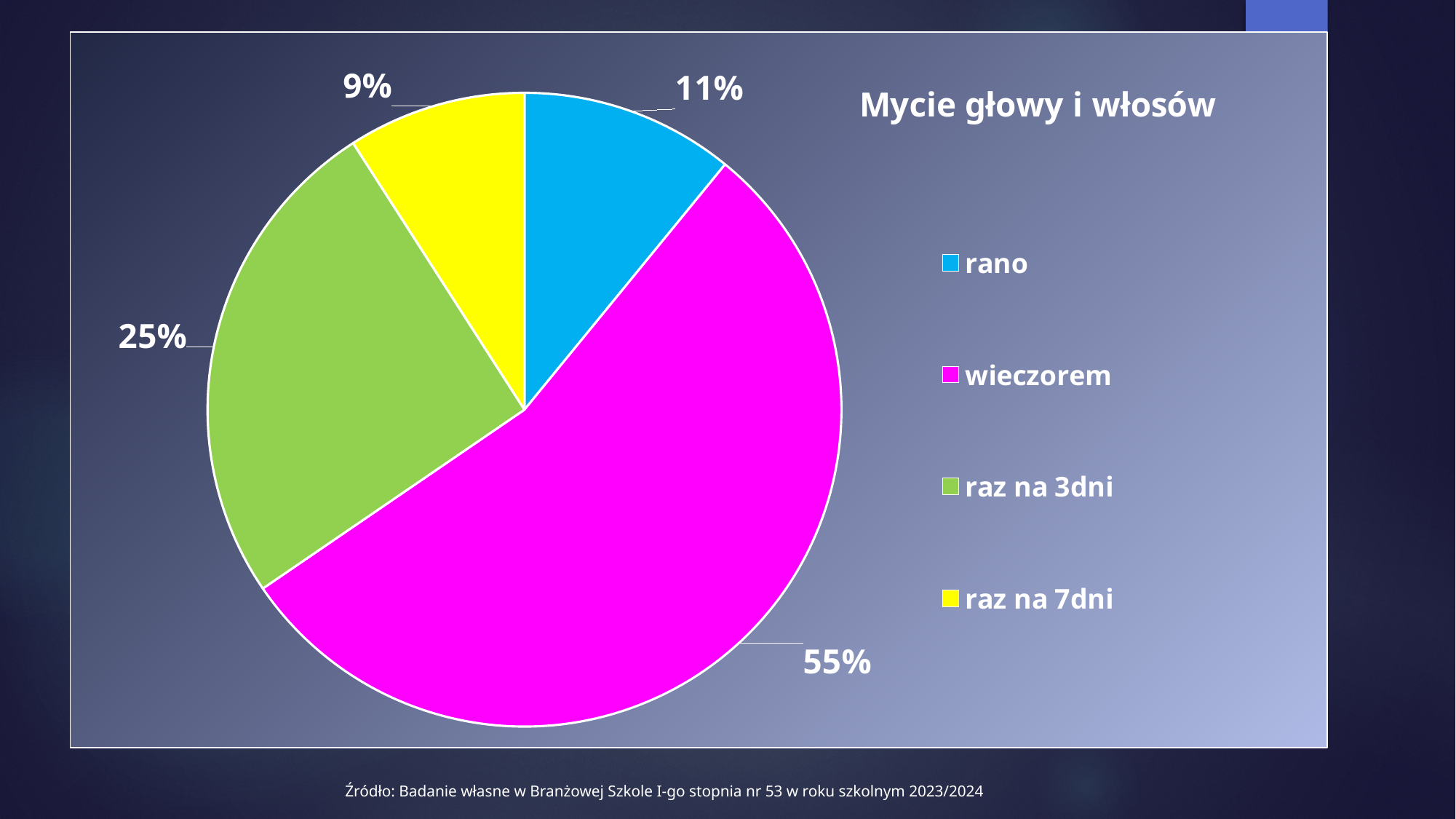
Which category has the smallest slice of the pie? raz na 7dni What percentage of the pie is labelled for 'raz na 7dni'? 9% What is the title of the chart? Mycie głowy i włosów Which category has the largest slice of the pie? wieczorem What is the difference in percentage points between 'wieczorem' and 'raz na 3dni'? 30 How many categories does the legend list? 4 What kind of chart is shown on the slide? pie chart What percentage of the pie is labelled for 'wieczorem'? 55% What colour is the slice for 'raz na 3dni'? green Which is larger, the slice for 'rano' or the slice for 'raz na 7dni'? rano What percentage of the pie is labelled for 'rano'? 11% What percentage of the pie is labelled for 'raz na 3dni'? 25%